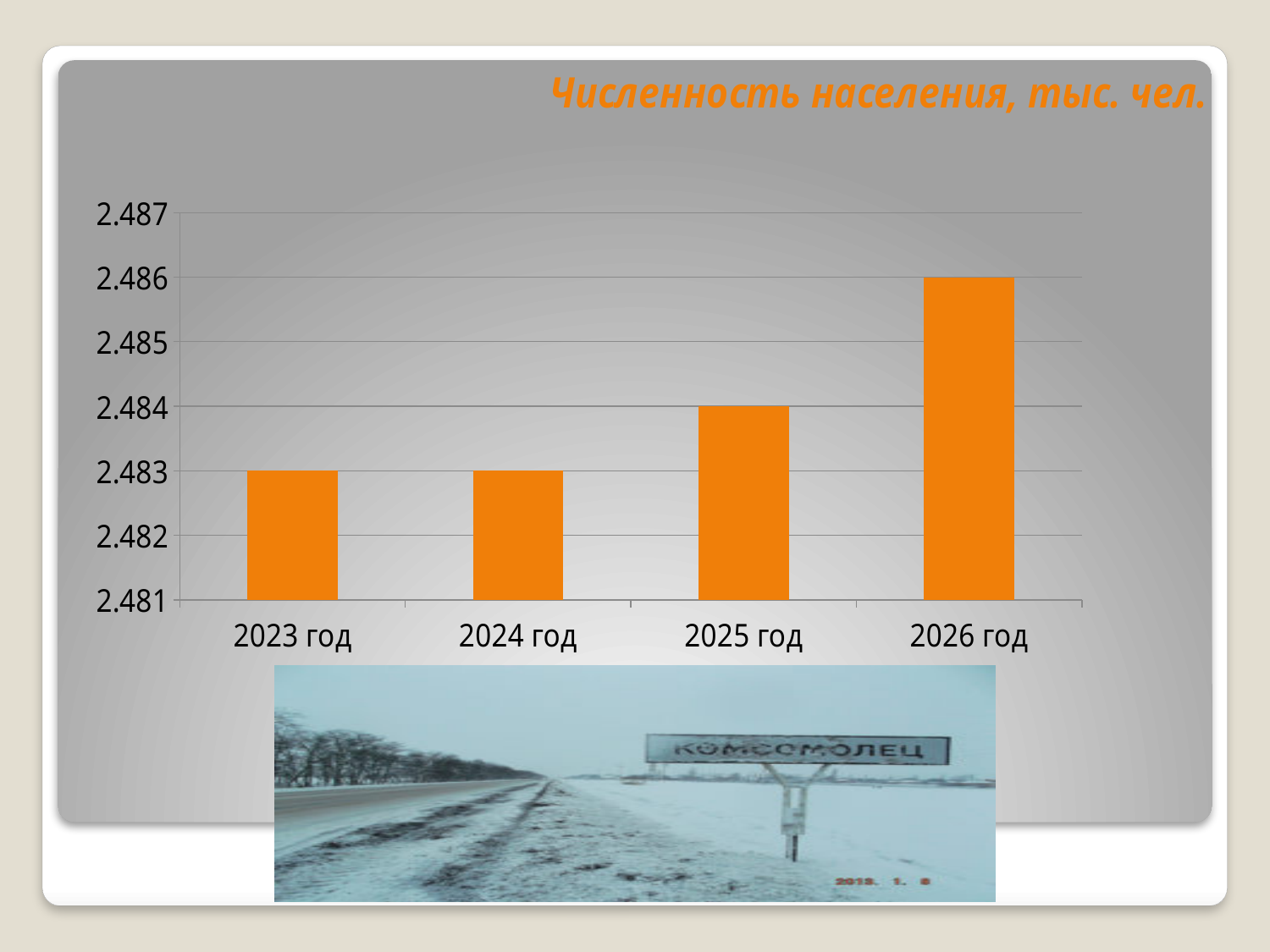
What is the difference between the values for 2025 год and 2024 год? 0.001 What is the difference between the values for 2026 год and 2023 год? 0.003 Which year has the highest value? 2026 год Is the value for 2026 год greater or less than 2.485? greater What is the value for 2025 год? 2.484 What is the value for 2026 год? 2.486 Do the values rise or fall from 2023 год to 2026 год? rise What is the title of the chart? Численность населения, тыс. чел. What kind of chart is this? bar chart How many years are shown on the x axis? 4 What is the value for 2023 год? 2.483 Which is larger, the value for 2025 год or the value for 2024 год? 2025 год